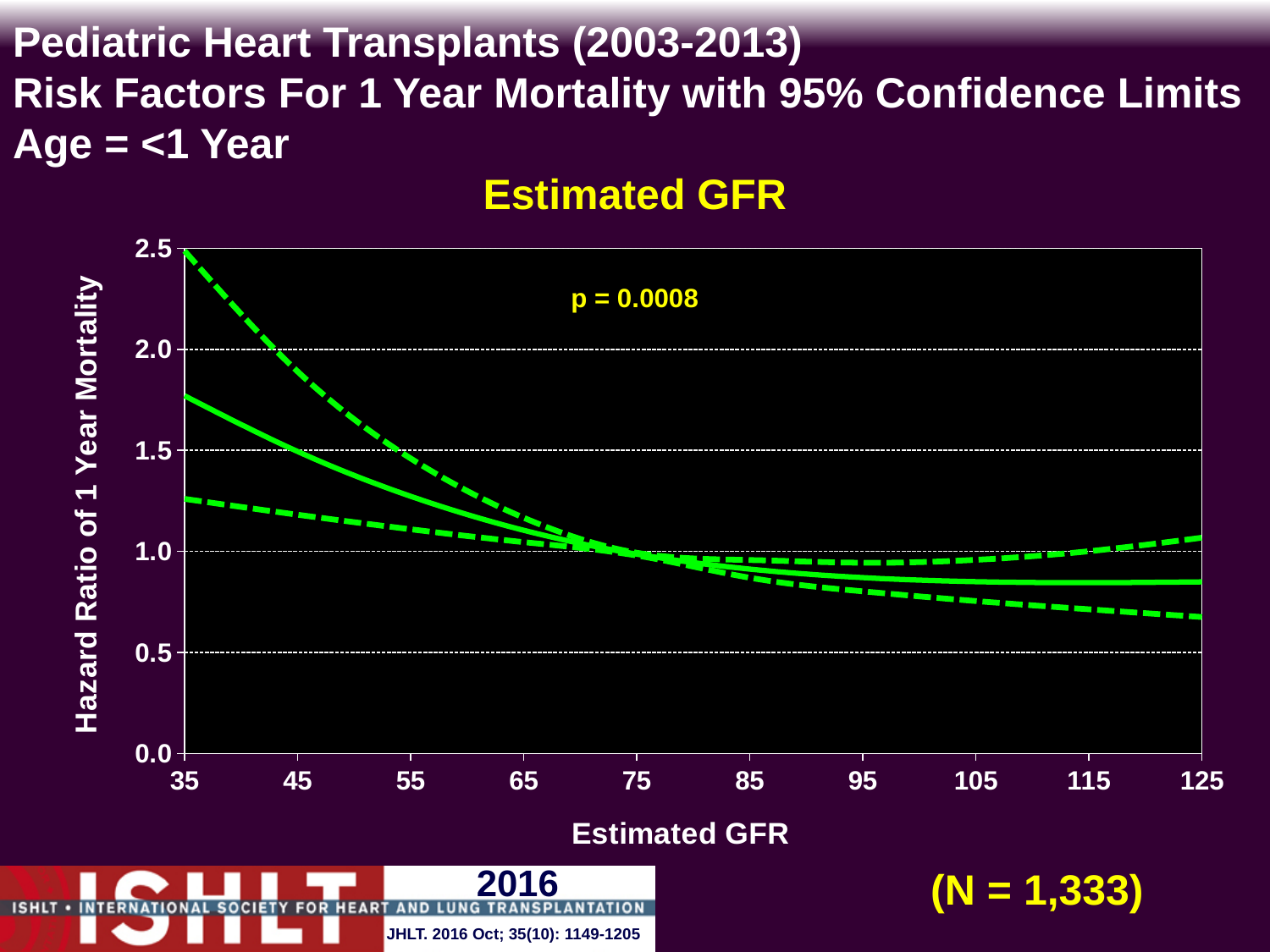
How many lines are plotted on the chart? 3 What is the title of the chart? Estimated GFR Is the hazard ratio on the solid line at an Estimated GFR of 35 greater or less than 1.5? greater What p-value is printed on the chart? p = 0.0008 Is the hazard ratio on the solid line at an Estimated GFR of 95 greater or less than 1.0? less Is the hazard ratio on the solid line at an Estimated GFR of 125 greater or less than 1.0? less What is the label of the y axis? Hazard Ratio of 1 Year Mortality What is the sample size (N) shown on the slide? 1,333 What kind of chart is shown on the slide? line chart Does the solid hazard ratio line rise or fall as Estimated GFR increases from 35 to 125? fall